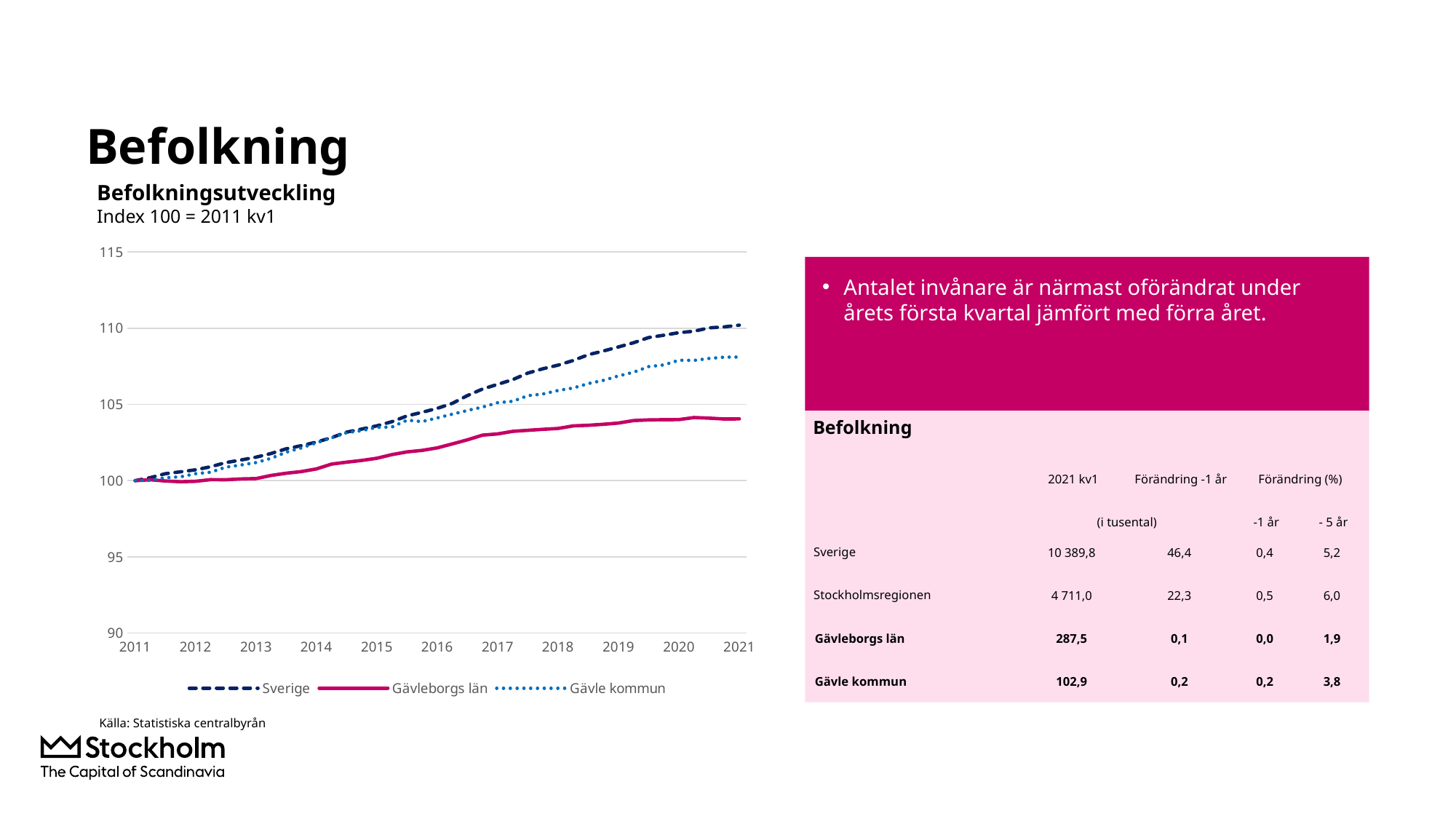
In the 'Befolkningsutveckling' chart, which series has the highest value in 2021? Sverige How many year labels are shown on the x axis of the 'Befolkningsutveckling' chart? 11 In the 'Befolkningsutveckling' chart, which is larger in 2019: Gävle kommun or Gävleborgs län? Gävle kommun What is the index base stated in the subtitle of the 'Befolkningsutveckling' chart? Index 100 = 2011 kv1 How many series does the legend of the 'Befolkningsutveckling' chart list? 3 Which series are listed in the legend of the 'Befolkningsutveckling' chart? Sverige, Gävleborgs län, Gävle kommun In the 'Befolkningsutveckling' chart, is the value for Gävleborgs län in 2021 greater or less than 105? less In the 'Befolkningsutveckling' chart, does the Sverige series rise or fall from 2011 to 2021? Rise In the 'Befolkningsutveckling' chart, is the value for Gävle kommun in 2021 greater or less than 105? greater What kind of chart is shown under the title 'Befolkningsutveckling'? Line chart In the 'Befolkningsutveckling' chart, which series has the lowest value in 2021? Gävleborgs län In the 'Befolkningsutveckling' chart, what is the index value of all three series at the start in 2011? 100